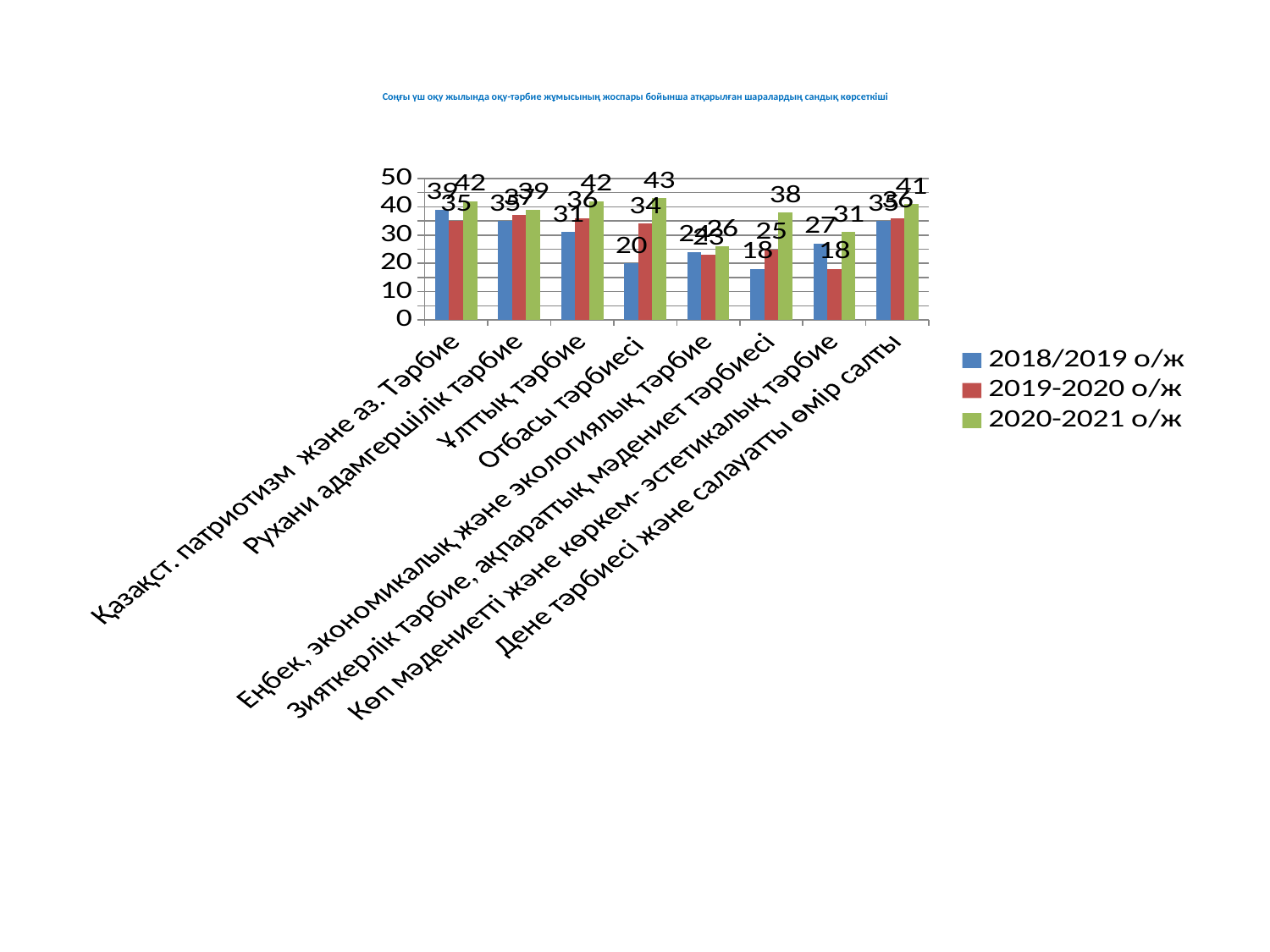
What is the difference between the 2020-2021 о/ж and 2018/2019 о/ж values for Отбасы тәрбиесі? 23 Which is larger for Қазақст. патриотизм және аз. Тәрбие: the 2018/2019 о/ж value or the 2019-2020 о/ж value? 2018/2019 о/ж What is the value for Ұлттық тәрбие in the 2019-2020 о/ж series? 36 What is the value for Зияткерлік тәрбие, ақпараттық мәдениет тәрбиесі in the 2018/2019 о/ж series? 18 Which category has the highest value in the 2020-2021 о/ж series? Отбасы тәрбиесі What is the value for Отбасы тәрбиесі in the 2020-2021 о/ж series? 43 Is the 2020-2021 о/ж value for Зияткерлік тәрбие, ақпараттық мәдениет тәрбиесі greater or less than 30? greater What kind of chart is shown on the slide? bar chart How many categories are shown on the x axis? 8 Which category has the lowest value in the 2019-2020 о/ж series? Көп мәдениетті және көркем-эстетикалық тәрбие What is the value for Көп мәдениетті және көркем-эстетикалық тәрбие in the 2020-2021 о/ж series? 31 How many series does the legend list? 3